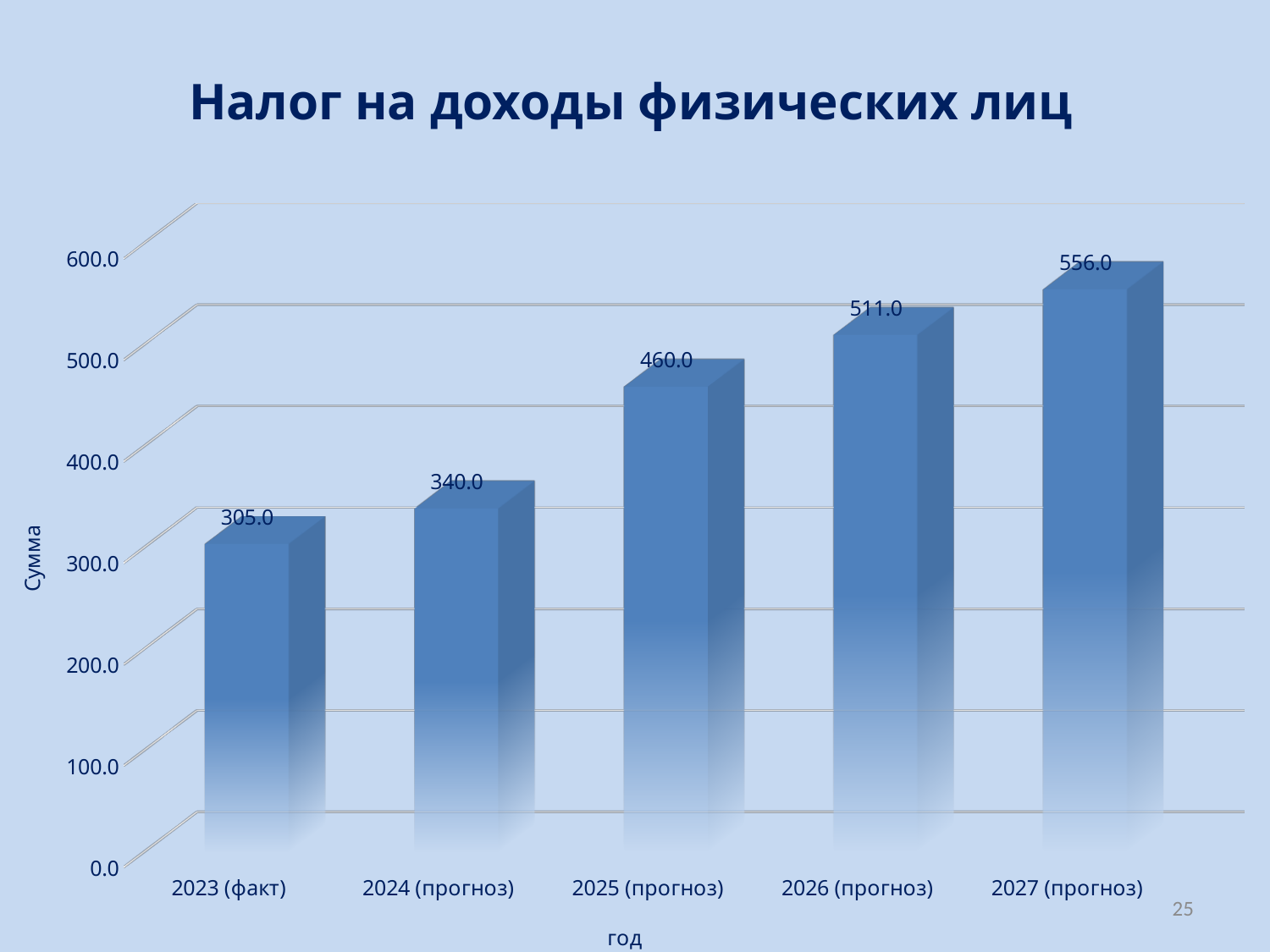
What is the difference between the values for 2024 (прогноз) and 2023 (факт)? 35.0 What is the difference between the values for 2027 (прогноз) and 2026 (прогноз)? 45.0 How many years are shown on the x axis? 5 Which year has the lowest value? 2023 (факт) What kind of chart is shown? bar chart Is the value for 2026 (прогноз) greater or less than 500.0? greater Which is larger, the value for 2025 (прогноз) or 2024 (прогноз)? 2025 (прогноз) Which year has the highest value? 2027 (прогноз) What is the value for 2023 (факт)? 305.0 What is the value for 2027 (прогноз)? 556.0 Do the values rise or fall from 2023 to 2027? rise What is the value for 2025 (прогноз)? 460.0